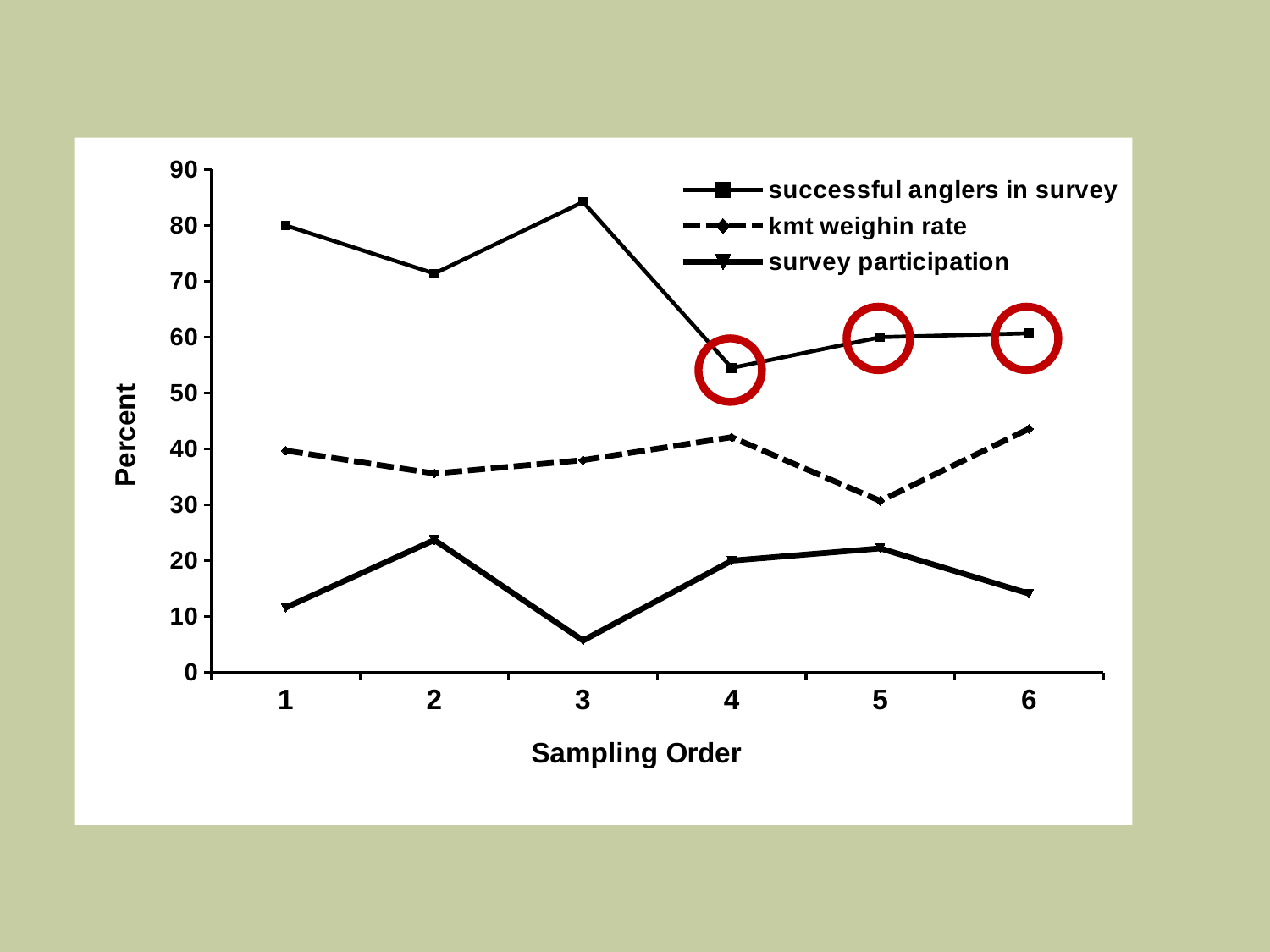
Is the kmt weighin rate at sampling order 5 greater or less than 40? less At which sampling order is survey participation lowest? 3 At sampling order 2, which is larger: successful anglers in survey or survey participation? successful anglers in survey At which sampling order is the value for successful anglers in survey lowest? 4 At which sampling order is the value for successful anglers in survey highest? 3 How many series does the legend list? 3 At which sampling order is the kmt weighin rate lowest? 5 Is the value for survey participation at sampling order 3 greater or less than 10? less How many sampling order points are plotted along the x axis? 6 What kind of chart is shown on the slide? line chart What is the label on the y axis? Percent Is the value for successful anglers in survey at sampling order 3 greater or less than 80? greater